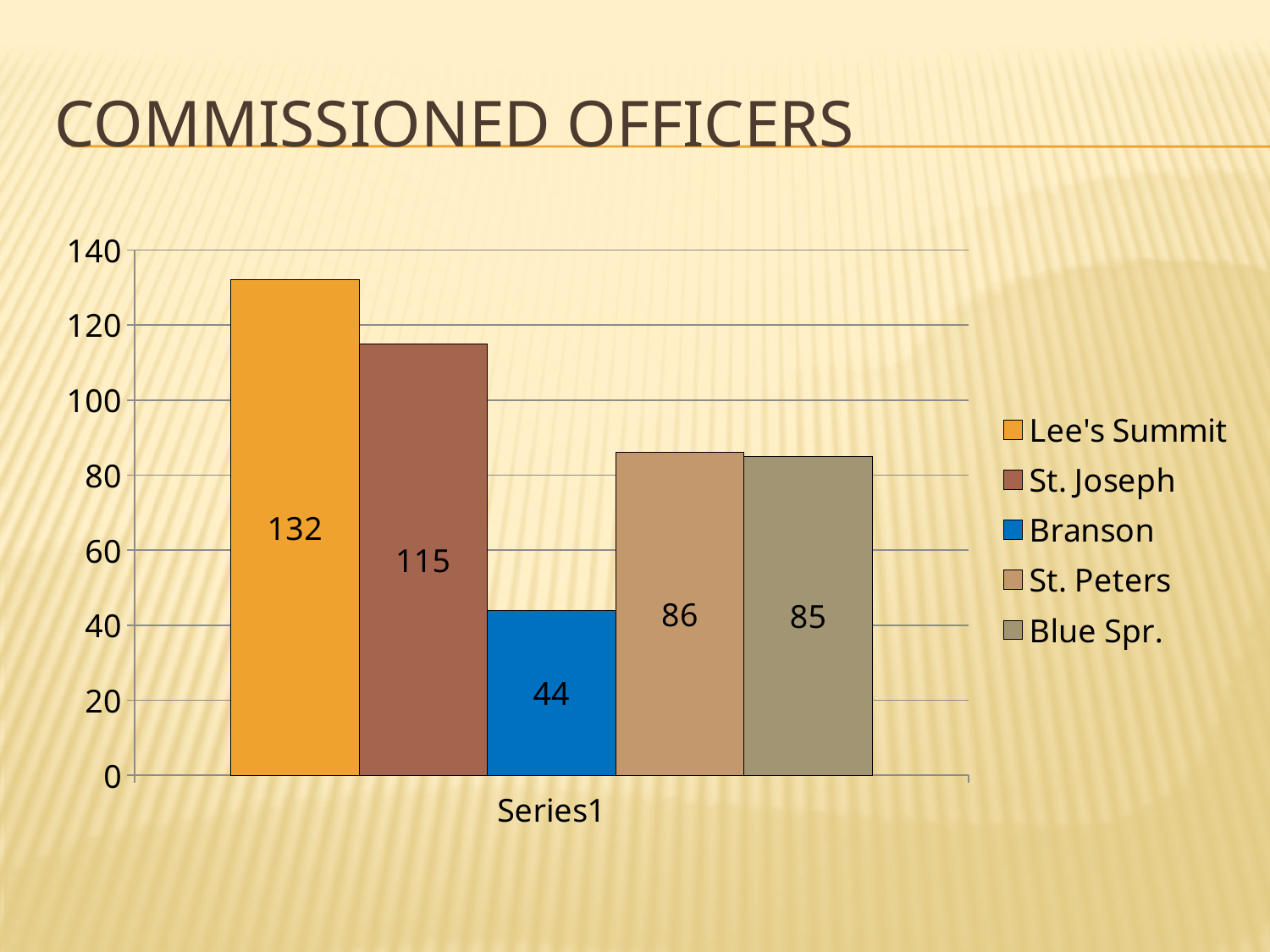
Which legend entry has the lowest value? Branson Which is larger, the value for St. Joseph or the value for Blue Spr.? St. Joseph What is the value for St. Peters? 86 What is the difference between the values for St. Peters and Branson? 42 How many bars are plotted in the chart? 5 What kind of chart is shown on the slide? bar chart What is the title of the slide? COMMISSIONED OFFICERS What is the difference between the values for Lee's Summit and St. Joseph? 17 Which legend entry has the highest value? Lee's Summit What is the value for Lee's Summit? 132 Is the value for St. Joseph greater or less than 100? greater What is the value for Branson? 44